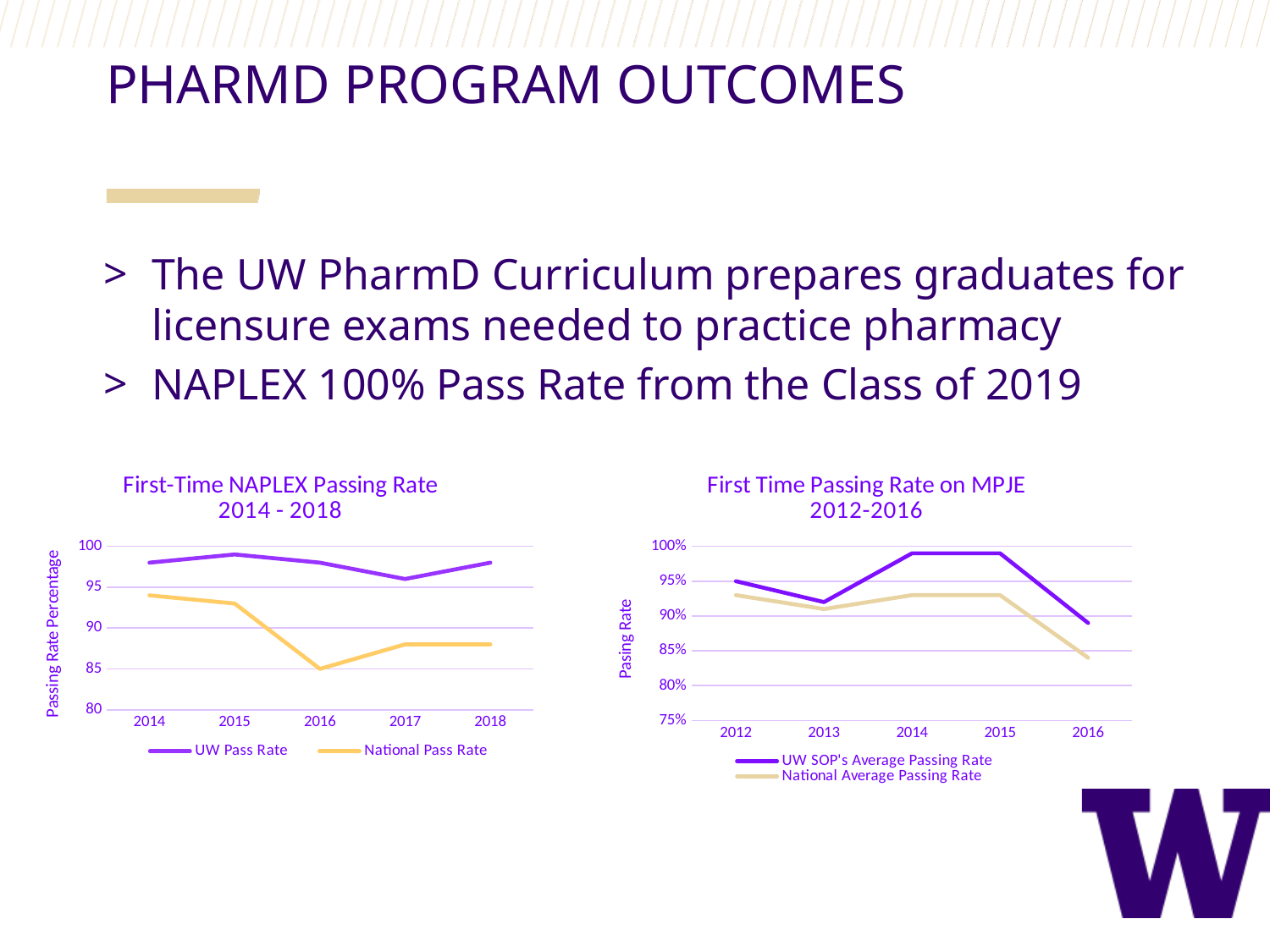
What kind of chart is the 'First Time Passing Rate on MPJE 2012-2016' chart? line chart In the 'First-Time NAPLEX Passing Rate 2014 - 2018' chart, which series has the larger value in 2016, UW Pass Rate or National Pass Rate? UW Pass Rate In the 'First-Time NAPLEX Passing Rate 2014 - 2018' chart, which year has the lowest National Pass Rate? 2016 In the 'First-Time NAPLEX Passing Rate 2014 - 2018' chart, is the UW Pass Rate for 2017 greater or less than 95? greater In the 'First Time Passing Rate on MPJE 2012-2016' chart, which year has the lowest UW SOP's Average Passing Rate? 2016 In the 'First Time Passing Rate on MPJE 2012-2016' chart, is the National Average Passing Rate for 2016 greater or less than 90%? less In the 'First-Time NAPLEX Passing Rate 2014 - 2018' chart, is the National Pass Rate for 2015 greater or less than 90? greater How many series does the legend of the 'First-Time NAPLEX Passing Rate 2014 - 2018' chart list? 2 What kind of chart is the 'First-Time NAPLEX Passing Rate 2014 - 2018' chart? line chart In the 'First-Time NAPLEX Passing Rate 2014 - 2018' chart, which year has the highest UW Pass Rate? 2015 How many years are plotted on the x axis of the 'First-Time NAPLEX Passing Rate 2014 - 2018' chart? 5 In the 'First Time Passing Rate on MPJE 2012-2016' chart, does the UW SOP's Average Passing Rate rise or fall from 2015 to 2016? fall